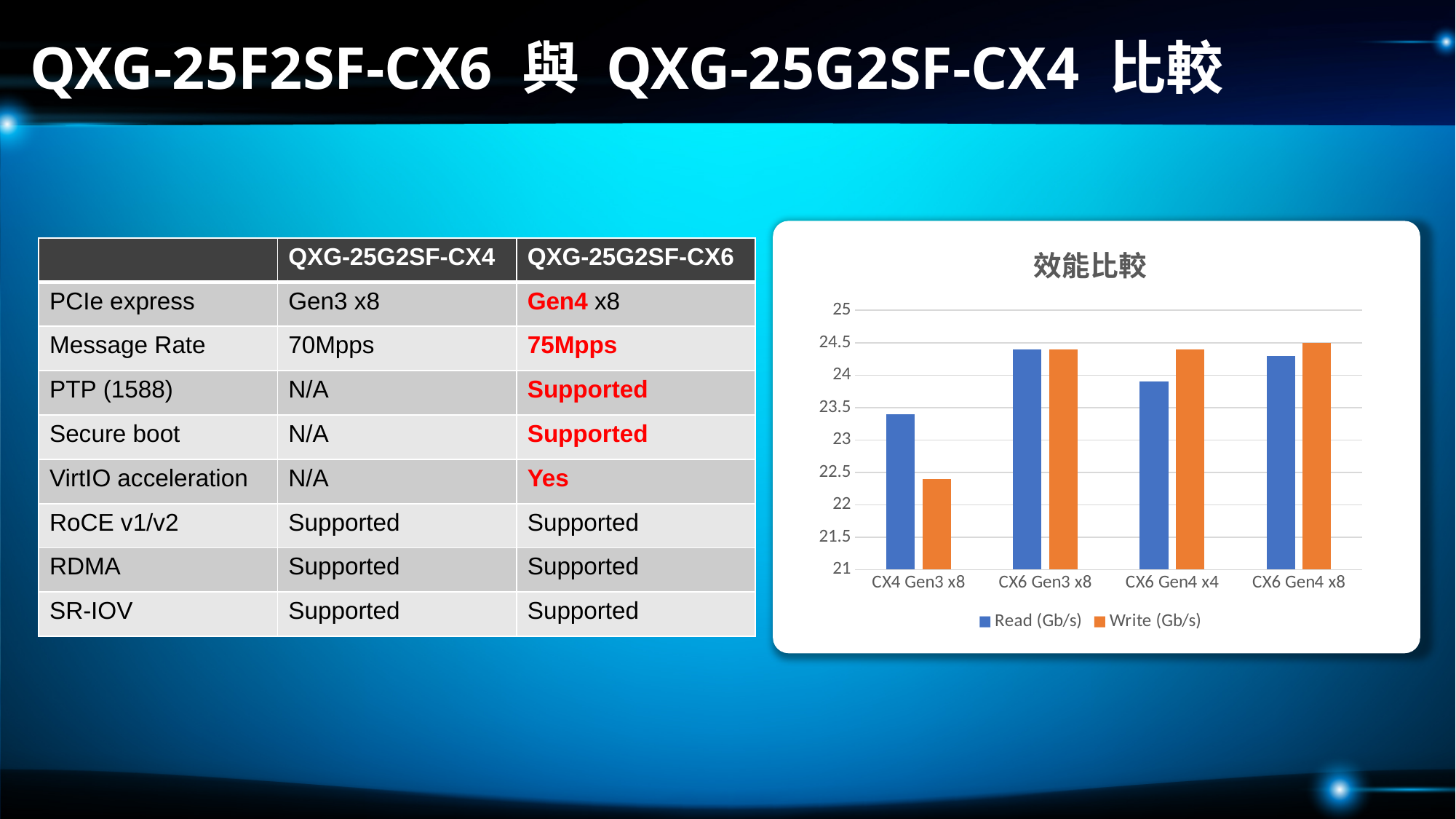
What kind of chart is shown on the slide? bar chart How many series does the chart legend list? 2 Is the Write (Gb/s) value for CX4 Gen3 x8 greater or less than 23? less Which category has the lowest Read (Gb/s) value? CX4 Gen3 x8 What is the title of the chart? 效能比較 Is the Read (Gb/s) value for CX6 Gen3 x8 greater or less than 24? greater Is the Read (Gb/s) value for CX4 Gen3 x8 greater or less than 23? greater For CX4 Gen3 x8, which is larger: Read (Gb/s) or Write (Gb/s)? Read (Gb/s) Which category has the lowest Write (Gb/s) value? CX4 Gen3 x8 Which series is shown in orange in the chart? Write (Gb/s) How many categories are shown on the x axis of the chart? 4